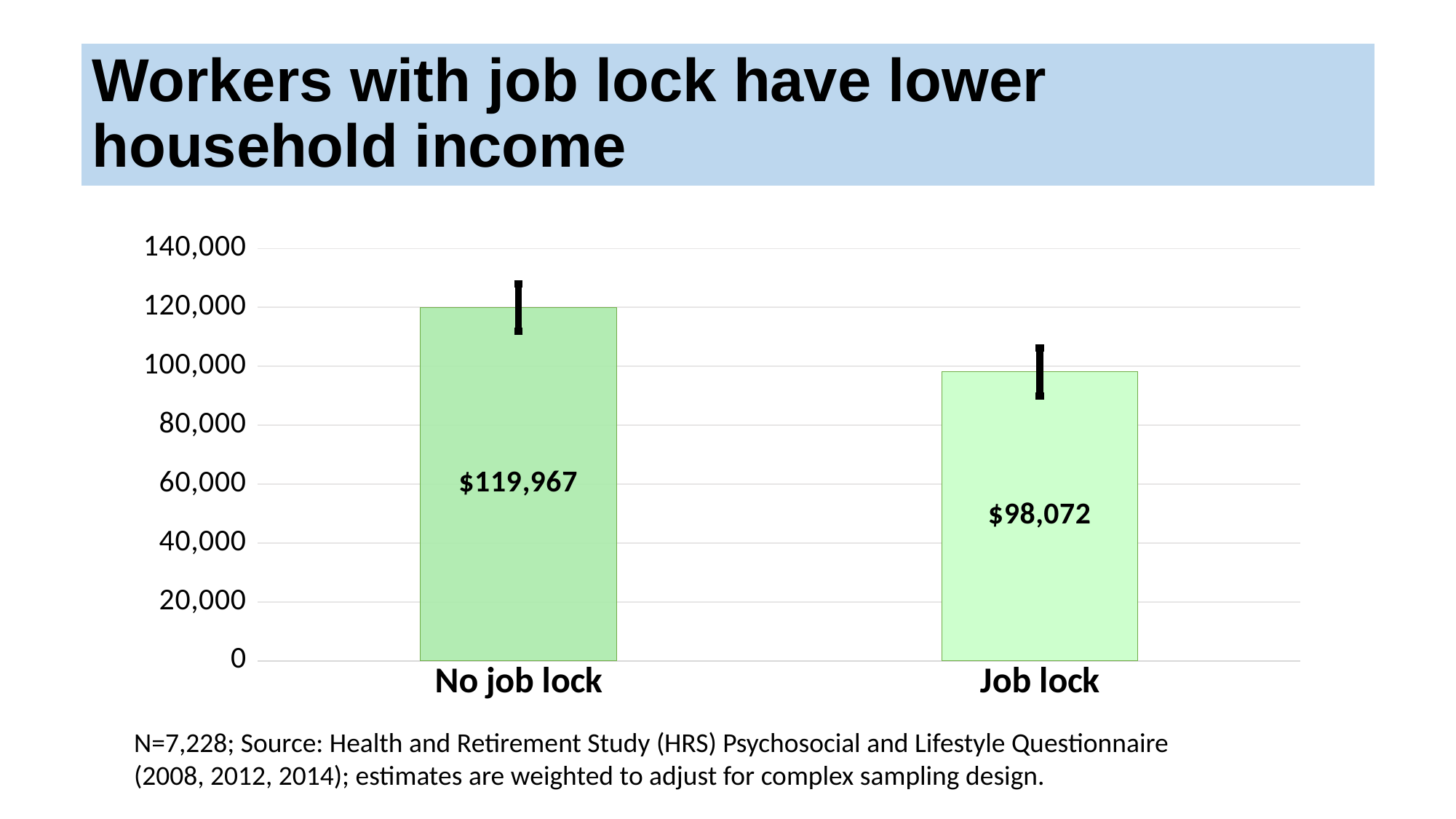
Is the value for Job lock greater or less than 100,000? less What kind of chart is shown on the slide? bar chart What is the household income value for Job lock? $98,072 How many categories are shown on the chart? 2 What is the difference between the household income for No job lock and Job lock? $21,895 What is the household income value for No job lock? $119,967 Which category has the lower household income? Job lock Is the value for No job lock larger or smaller than the value for Job lock? larger What is the sample size (N) stated in the note below the chart? 7,228 Is the value for No job lock greater or less than 100,000? greater Which category has the higher household income? No job lock What is the title of the slide? Workers with job lock have lower household income